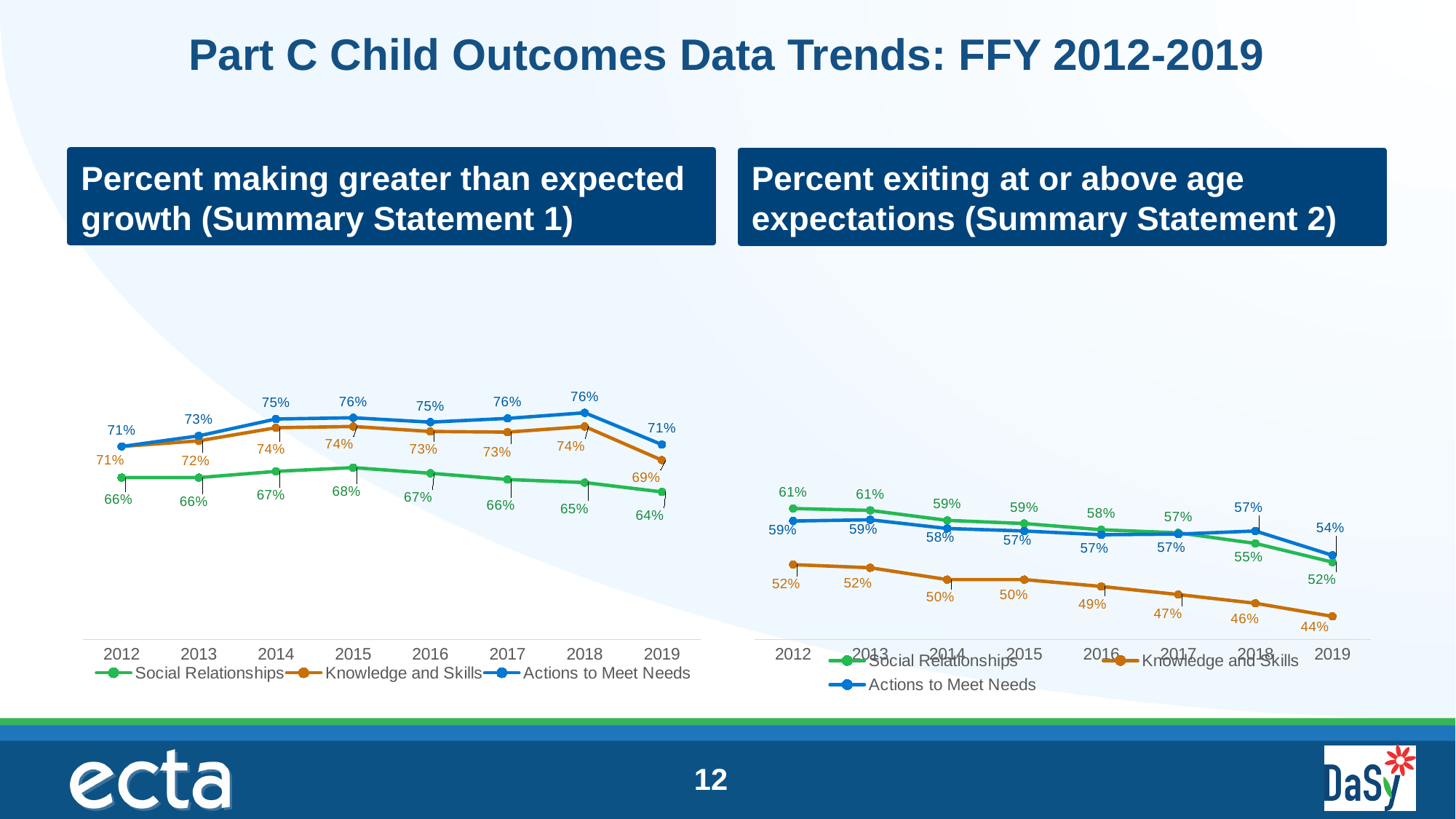
In the 'Percent exiting at or above age expectations (Summary Statement 2)' chart, which series has the lowest values across all years? Knowledge and Skills In the 'Percent exiting at or above age expectations (Summary Statement 2)' chart, what is the difference between the Knowledge and Skills values in 2012 and 2019? 8 percentage points How many years are plotted on the x axis of the 'Percent making greater than expected growth (Summary Statement 1)' chart? 8 In the 'Percent exiting at or above age expectations (Summary Statement 2)' chart, what is the value for Social Relationships in 2012? 61% What kind of chart is the 'Percent exiting at or above age expectations (Summary Statement 2)' chart? Line chart In the 'Percent making greater than expected growth (Summary Statement 1)' chart, what is the value for Actions to Meet Needs in 2019? 71% In the 'Percent exiting at or above age expectations (Summary Statement 2)' chart, what is the value for Knowledge and Skills in 2019? 44% In the 'Percent exiting at or above age expectations (Summary Statement 2)' chart, which is larger in 2019: Social Relationships or Actions to Meet Needs? Actions to Meet Needs How many series does the legend of the 'Percent exiting at or above age expectations (Summary Statement 2)' chart list? 3 In the 'Percent making greater than expected growth (Summary Statement 1)' chart, what is the value for Social Relationships in 2015? 68% In the 'Percent making greater than expected growth (Summary Statement 1)' chart, what is the difference between Actions to Meet Needs and Social Relationships in 2018? 11 percentage points In the 'Percent making greater than expected growth (Summary Statement 1)' chart, which year has the lowest value for Social Relationships? 2019